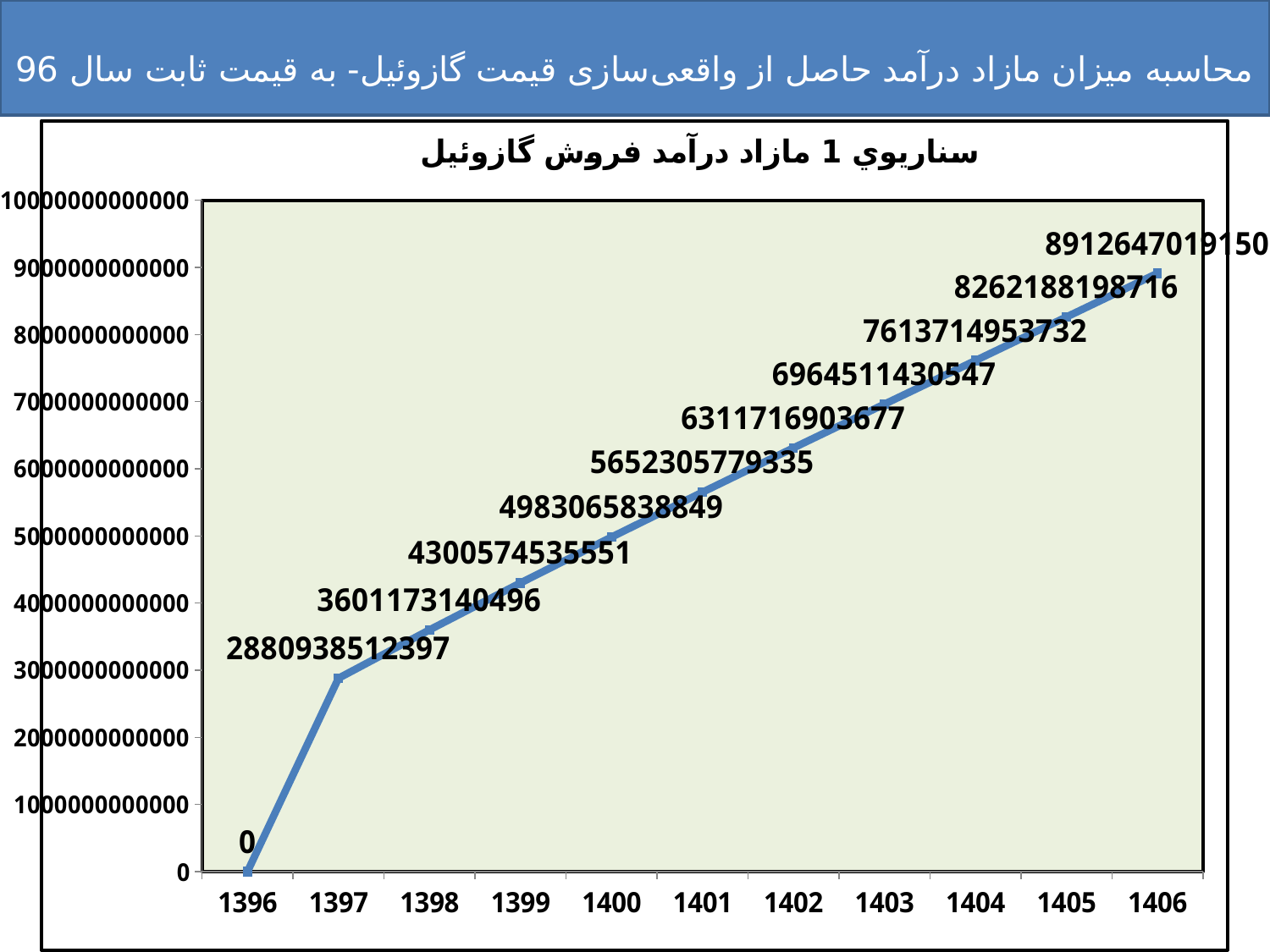
How many years are plotted on the x axis? 11 What kind of chart is this? line chart Which year has the highest value? 1406 What is the value for 1406? 8912647019150 Which year has the lowest value? 1396 What is the difference between the values for 1398 and 1397? 720234628099 What is the value for 1396? 0 Do the values rise or fall from 1396 to 1406? rise Is the value for 1402 greater or less than 6000000000000? greater What is the value for 1397? 2880938512397 What is the value for 1401? 5652305779335 Which is larger, the value for 1403 or the value for 1400? 1403